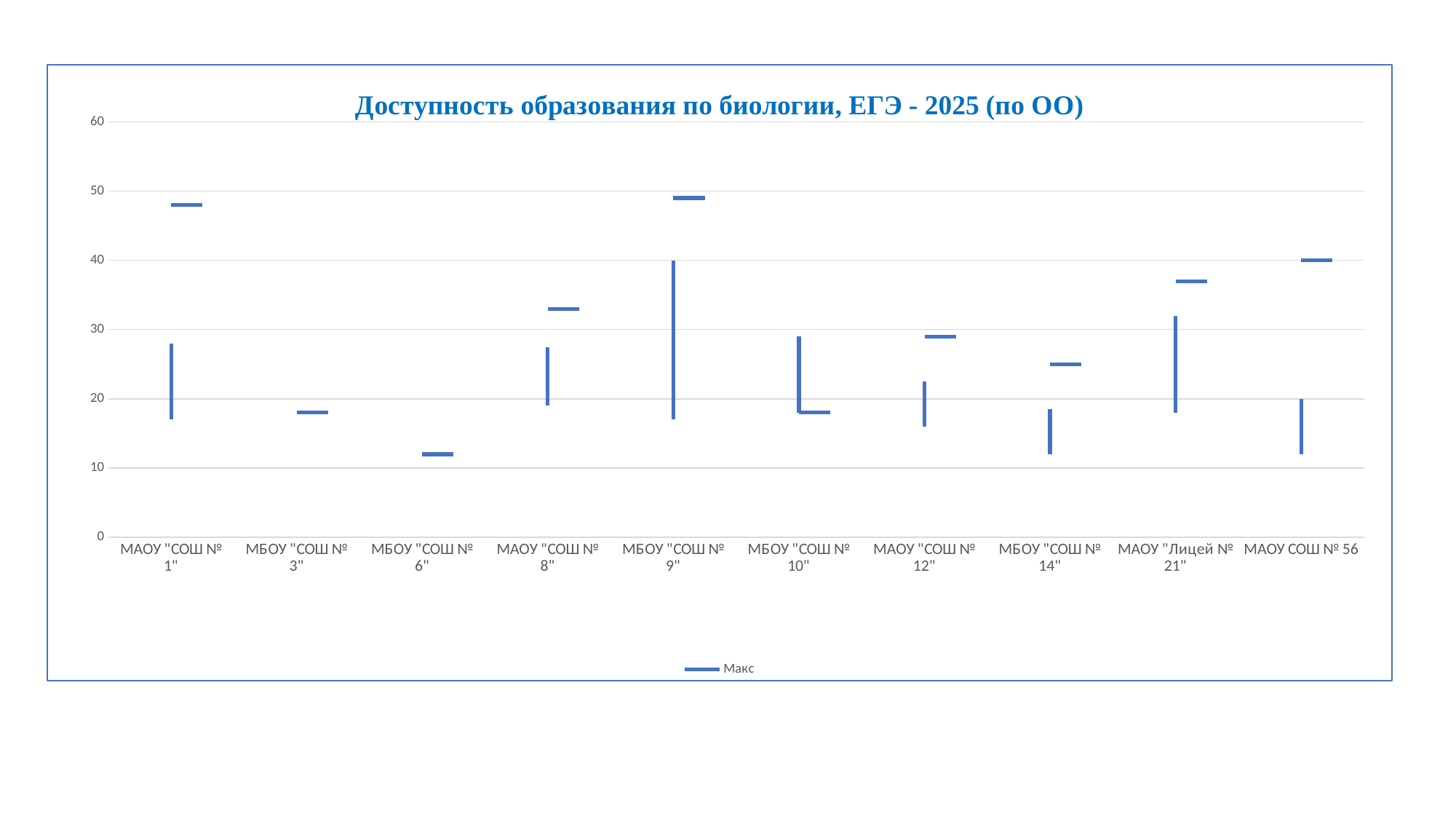
What is the title of the chart? Доступность образования по биологии, ЕГЭ - 2025 (по ОО) Is the Макс value for МАОУ "Лицей № 21" greater or less than 30? greater Which has the larger Макс value, МАОУ "СОШ № 8" or МАОУ "СОШ № 12"? МАОУ "СОШ № 8" How many schools (categories) are shown on the x axis? 10 Is the Макс value for МБОУ "СОШ № 3" greater or less than 20? less What is the name of the series shown in the legend? Макс Which school has the lowest Макс value? МБОУ "СОШ № 6" What is the Макс value for МАОУ СОШ № 56? 40 How many series does the legend list? 1 Which has the larger Макс value, МБОУ "СОШ № 10" or МАОУ "Лицей № 21"? МАОУ "Лицей № 21" Is the Макс value for МБОУ "СОШ № 14" greater or less than 30? less